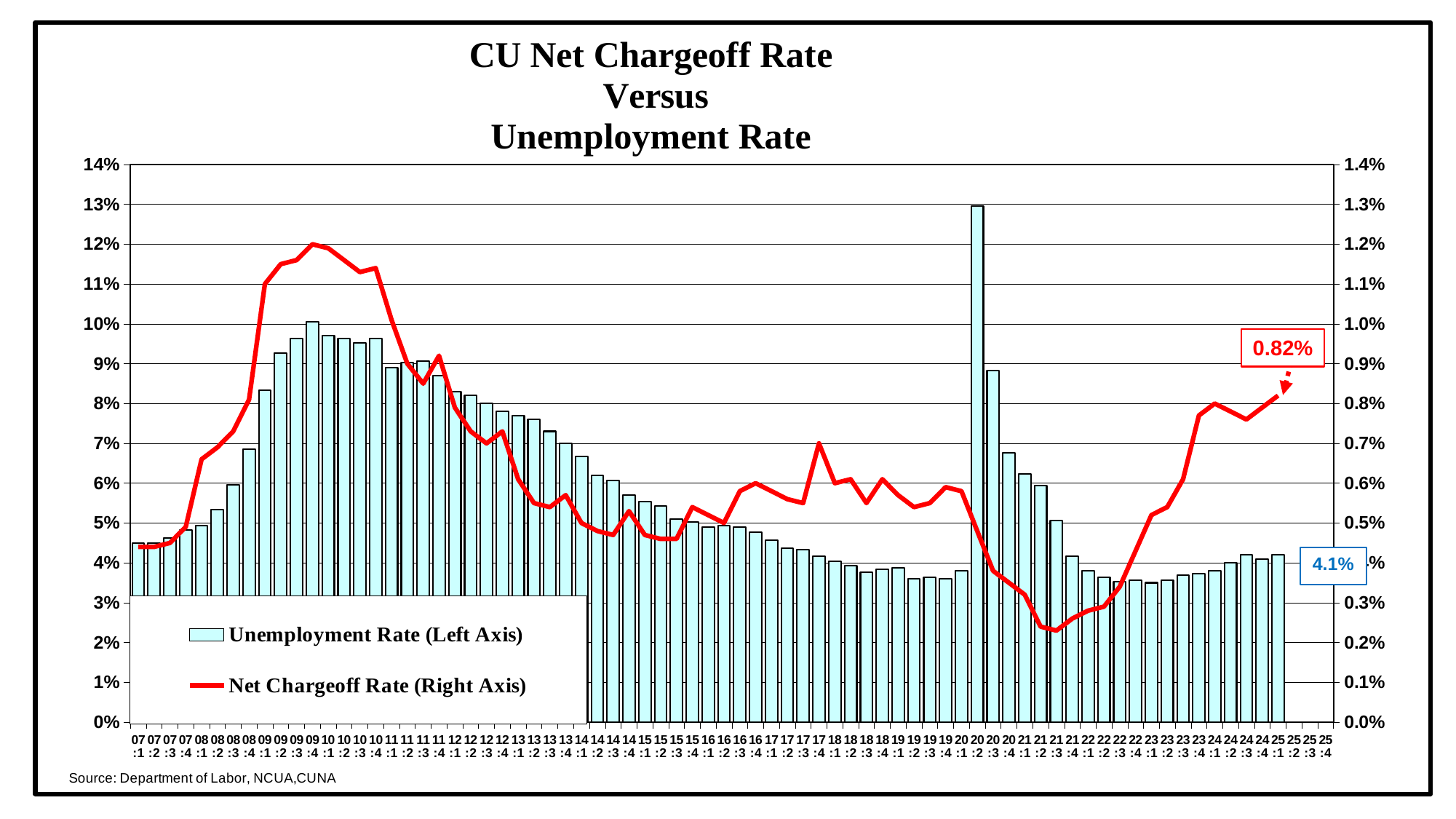
What kind of chart is this? A bar chart combined with a line chart What is the labeled value of the Unemployment Rate at the end of the series (25:1)? 4.1% Is the Unemployment Rate in 20:2 greater or less than 12%? greater How many series does the legend list? 2 Is the Unemployment Rate in 07:1 greater or less than 5%? less Which is larger, the Unemployment Rate in 09:4 or in 07:1? 09:4 Is the Net Chargeoff Rate in 09:4 greater or less than 1.1%? greater What is the labeled value of the Net Chargeoff Rate at the end of the series (25:1)? 0.82% Does the Unemployment Rate rise or fall from 10:1 to 19:4? fall In which quarter is the Unemployment Rate bar the highest? 20:2 What source is cited for the chart data? Department of Labor, NCUA, CUNA What is the title of the chart? CU Net Chargeoff Rate Versus Unemployment Rate